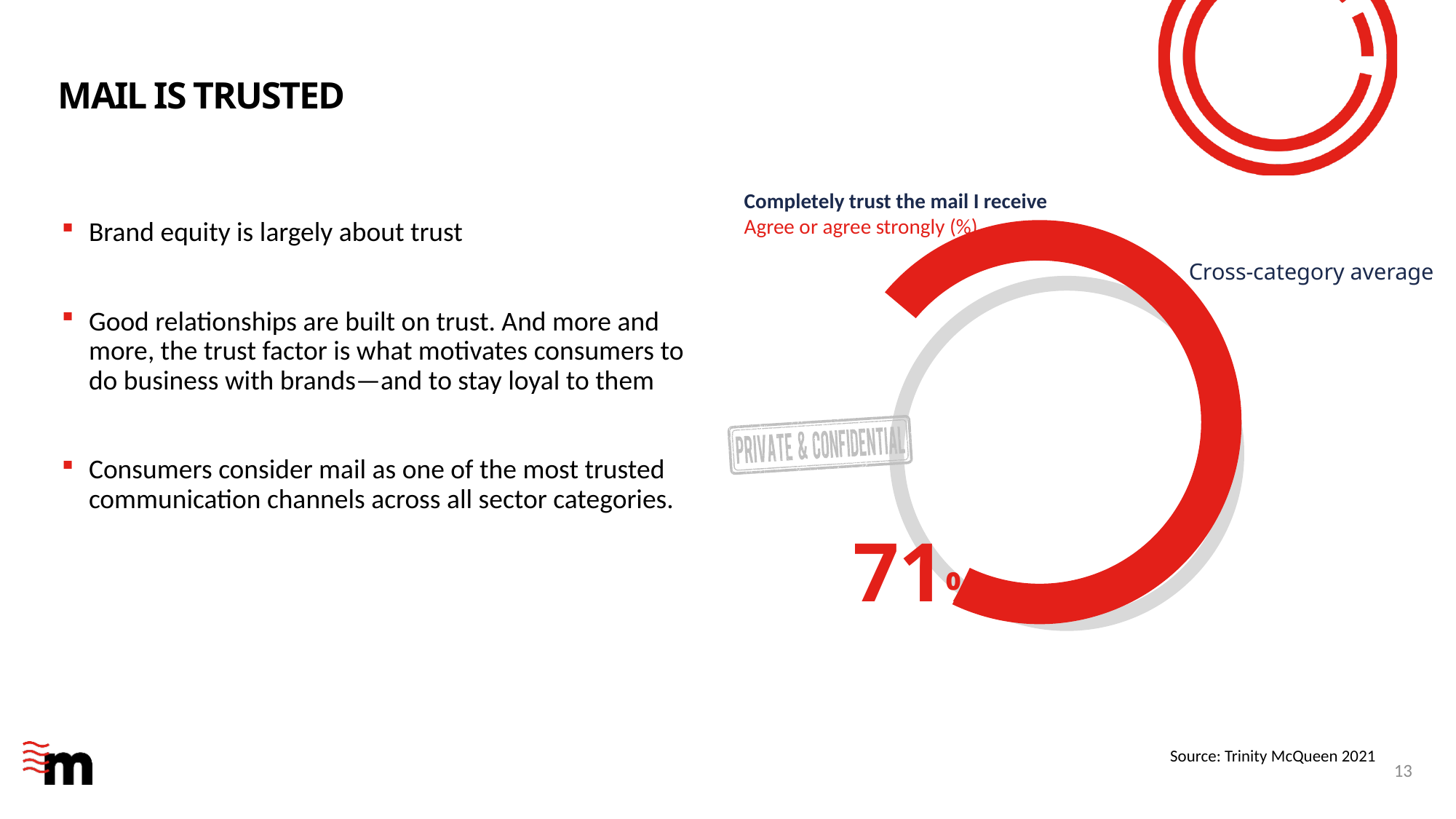
How many data values are printed on the doughnut chart? 1 What colour is the filled portion of the doughnut chart representing 71%? Red What percentage of respondents agree or agree strongly that they completely trust the mail they receive? 71% What is the title of the chart on the slide? Completely trust the mail I receive Is the value shown in the doughnut chart greater or less than 50%? greater What kind of chart is used to show the 71% figure? Doughnut (ring) chart